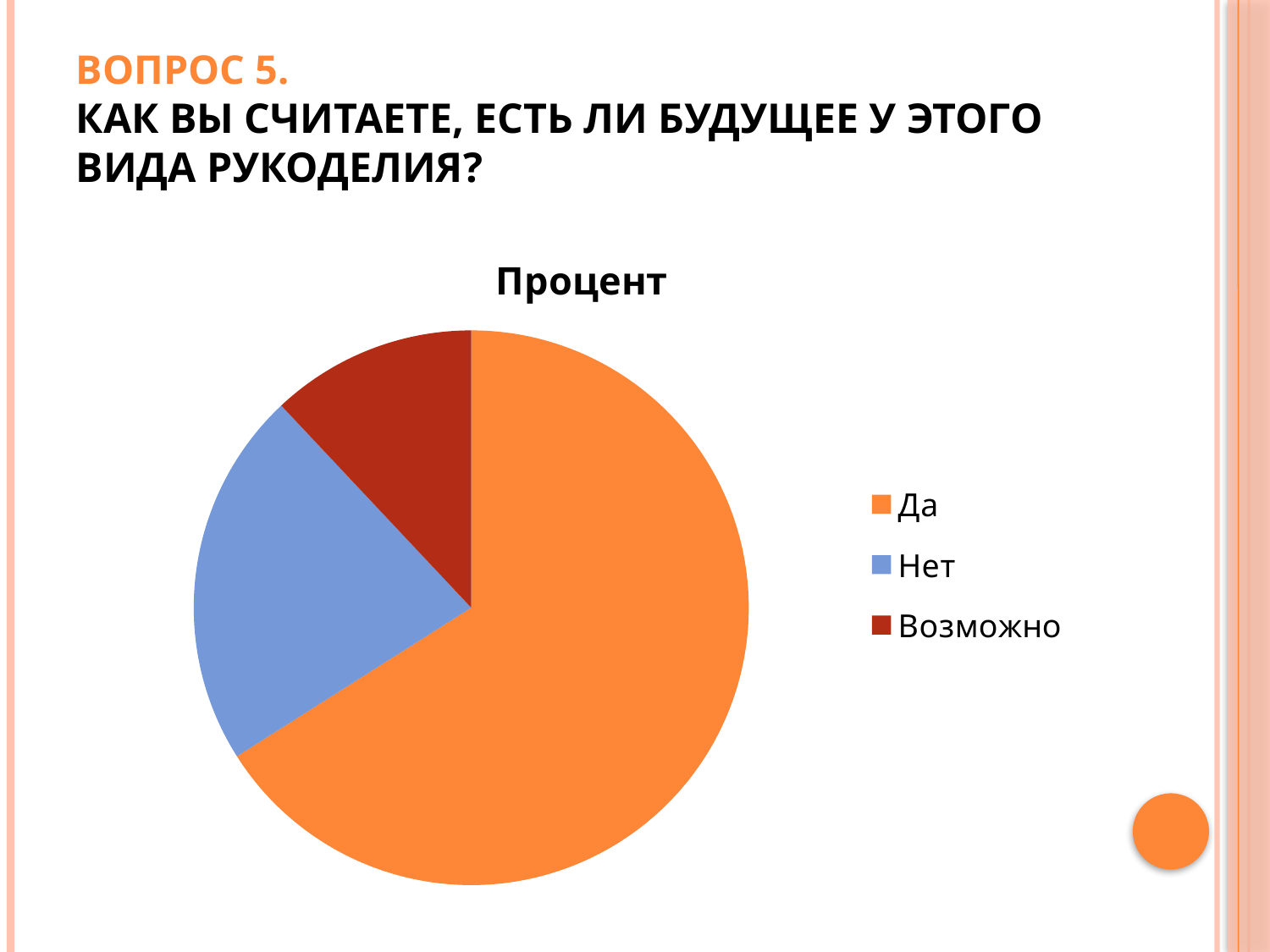
How many slices does the pie chart have? 3 What is the title of the chart? Процент Does the slice for Да take up more or less than half of the pie? more Which slice is larger, Нет or Возможно? Нет Which category has the smallest slice of the pie? Возможно Which colour represents the category Нет in the pie chart? blue What kind of chart is shown on the slide? pie chart Which category has the largest slice of the pie? Да Which slice is larger, Да or Нет? Да How many entries does the legend list? 3